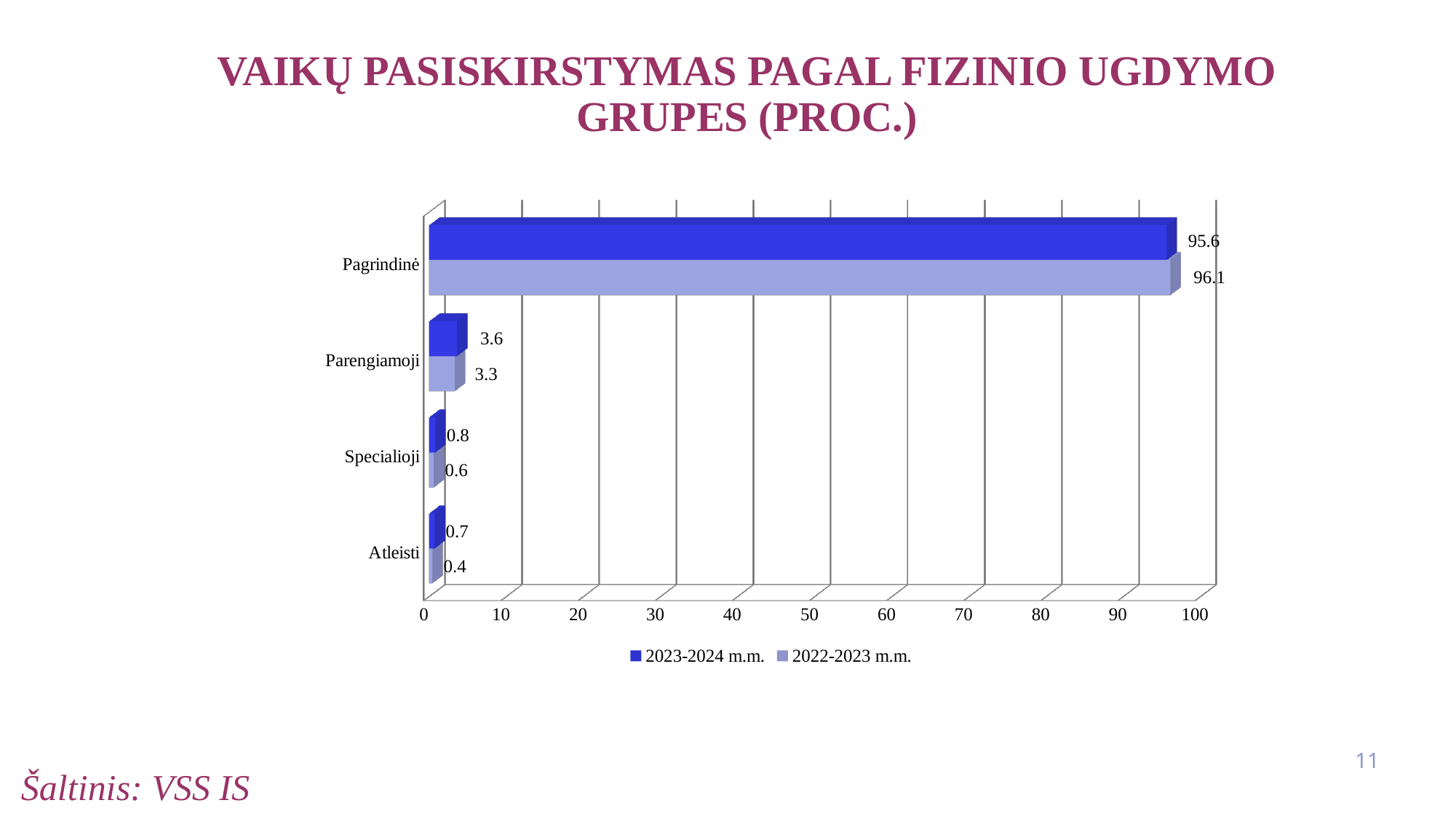
What is the value for Specialioji in the 2022-2023 m.m. series? 0.6 What is the value for Pagrindinė in the 2022-2023 m.m. series? 96.1 What is the value for Pagrindinė in the 2023-2024 m.m. series? 95.6 How many categories are shown on the chart? 4 What is the difference between the 2022-2023 m.m. and 2023-2024 m.m. values for Pagrindinė? 0.5 Which category has the highest value in the 2023-2024 m.m. series? Pagrindinė Which is larger for Parengiamoji: the 2023-2024 m.m. value or the 2022-2023 m.m. value? 2023-2024 m.m. What is the value for Atleisti in the 2023-2024 m.m. series? 0.7 Which category has the lowest value in the 2022-2023 m.m. series? Atleisti What is the value for Parengiamoji in the 2023-2024 m.m. series? 3.6 How many series does the legend list? 2 What kind of chart is shown on the slide? Bar chart